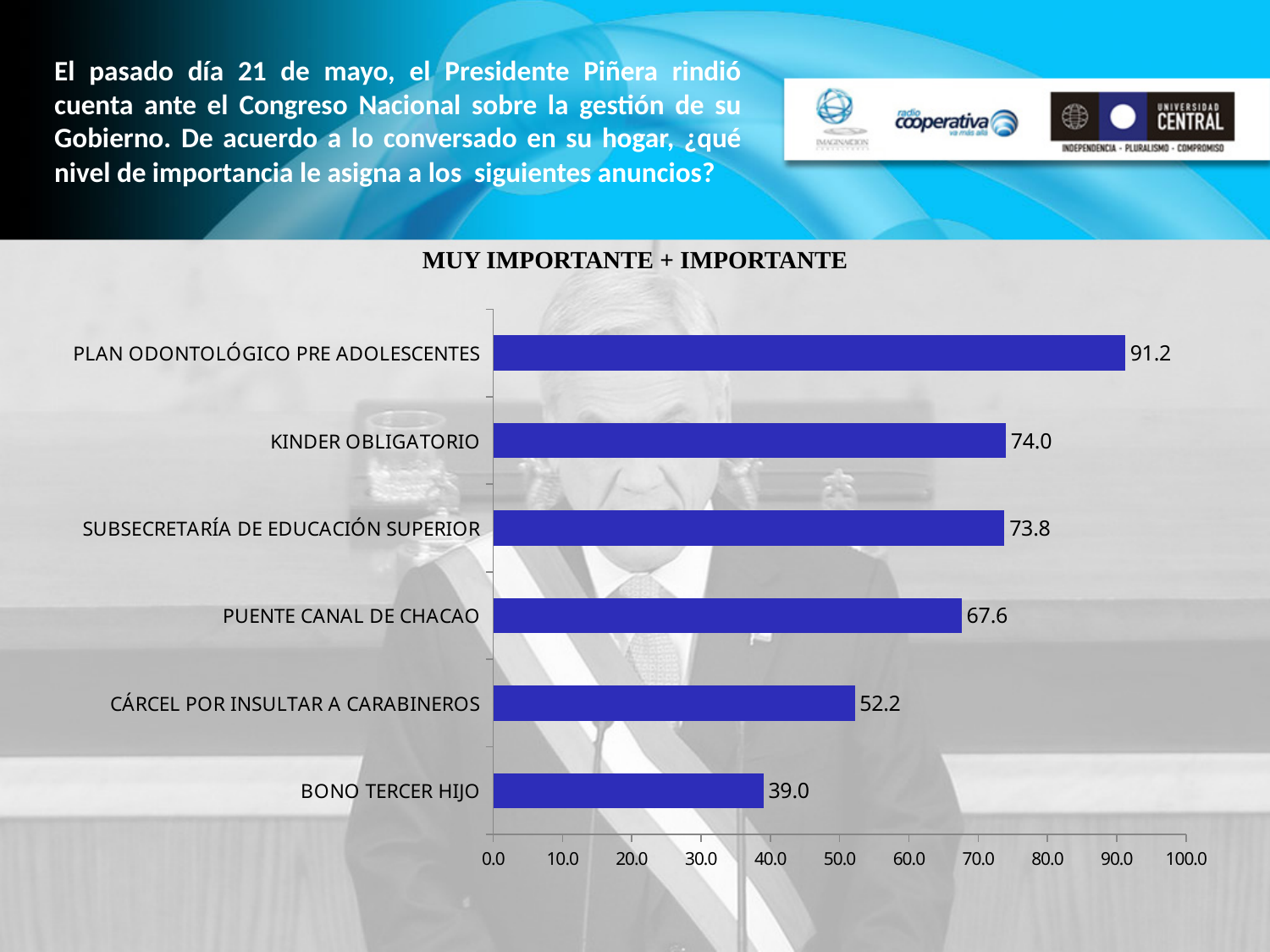
What is the title of the chart? MUY IMPORTANTE + IMPORTANTE Is the value for CÁRCEL POR INSULTAR A CARABINEROS greater or less than 50.0? greater What is the difference between the values for KINDER OBLIGATORIO and SUBSECRETARÍA DE EDUCACIÓN SUPERIOR? 0.2 What is the value for PLAN ODONTOLÓGICO PRE ADOLESCENTES? 91.2 Which category has the highest value? PLAN ODONTOLÓGICO PRE ADOLESCENTES Which is larger, the value for PUENTE CANAL DE CHACAO or the value for CÁRCEL POR INSULTAR A CARABINEROS? PUENTE CANAL DE CHACAO What is the difference between the values for PLAN ODONTOLÓGICO PRE ADOLESCENTES and BONO TERCER HIJO? 52.2 How many categories are shown in the chart? 6 Which category has the lowest value? BONO TERCER HIJO What is the value for BONO TERCER HIJO? 39.0 What is the value for PUENTE CANAL DE CHACAO? 67.6 What kind of chart is shown on the slide? bar chart